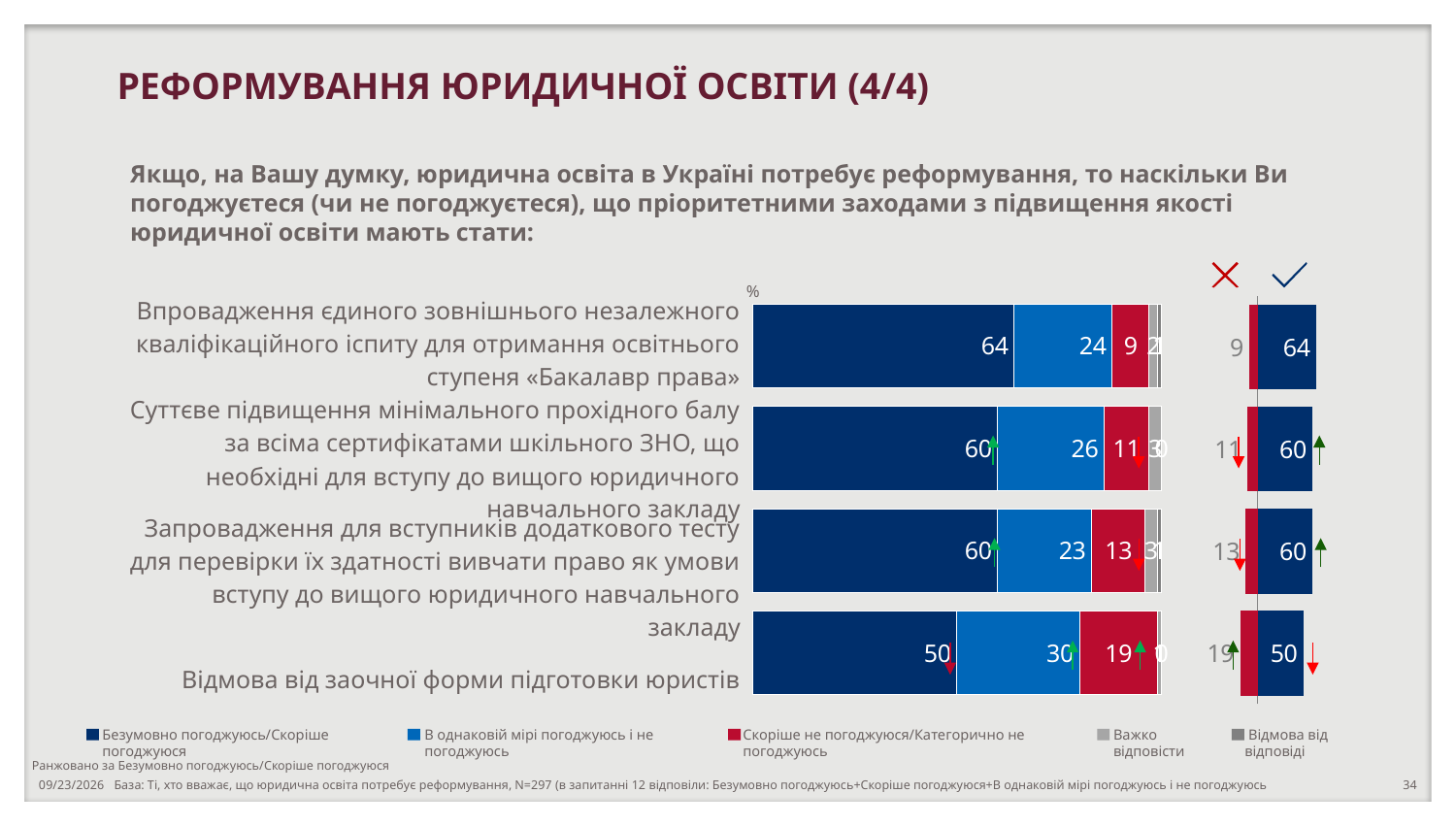
What is the difference between the «Скоріше не погоджуюся/Категорично не погоджуюсь» values for «Відмова від заочної форми підготовки юристів» and «Впровадження єдиного зовнішнього незалежного кваліфікаційного іспиту»? 10 What is the value of «Безумовно погоджуюсь/Скоріше погоджуюся» for «Відмова від заочної форми підготовки юристів»? 50 Which has a larger «В однаковій мірі погоджуюсь і не погоджуюсь» value: «Відмова від заочної форми підготовки юристів» or «Суттєве підвищення мінімального прохідного балу за всіма сертифікатами шкільного ЗНО»? Відмова від заочної форми підготовки юристів How many series does the legend list? 5 How many categories (statements) are shown in the chart? 4 Which category has the highest value for «Безумовно погоджуюсь/Скоріше погоджуюся»? Впровадження єдиного зовнішнього незалежного кваліфікаційного іспиту для отримання освітнього ступеня «Бакалавр права» Which category has the highest value for «Скоріше не погоджуюся/Категорично не погоджуюсь»? Відмова від заочної форми підготовки юристів What kind of chart is shown on the slide? Stacked bar chart Which category has the lowest value for «Безумовно погоджуюсь/Скоріше погоджуюся»? Відмова від заочної форми підготовки юристів What is the difference between the «Безумовно погоджуюсь/Скоріше погоджуюся» values for «Впровадження єдиного зовнішнього незалежного кваліфікаційного іспиту» and «Відмова від заочної форми підготовки юристів»? 14 What is the value of «В однаковій мірі погоджуюсь і не погоджуюсь» for «Впровадження єдиного зовнішнього незалежного кваліфікаційного іспиту для отримання освітнього ступеня «Бакалавр права»»? 24 What is the value of «Скоріше не погоджуюся/Категорично не погоджуюсь» for «Запровадження для вступників додаткового тесту для перевірки їх здатності вивчати право»? 13